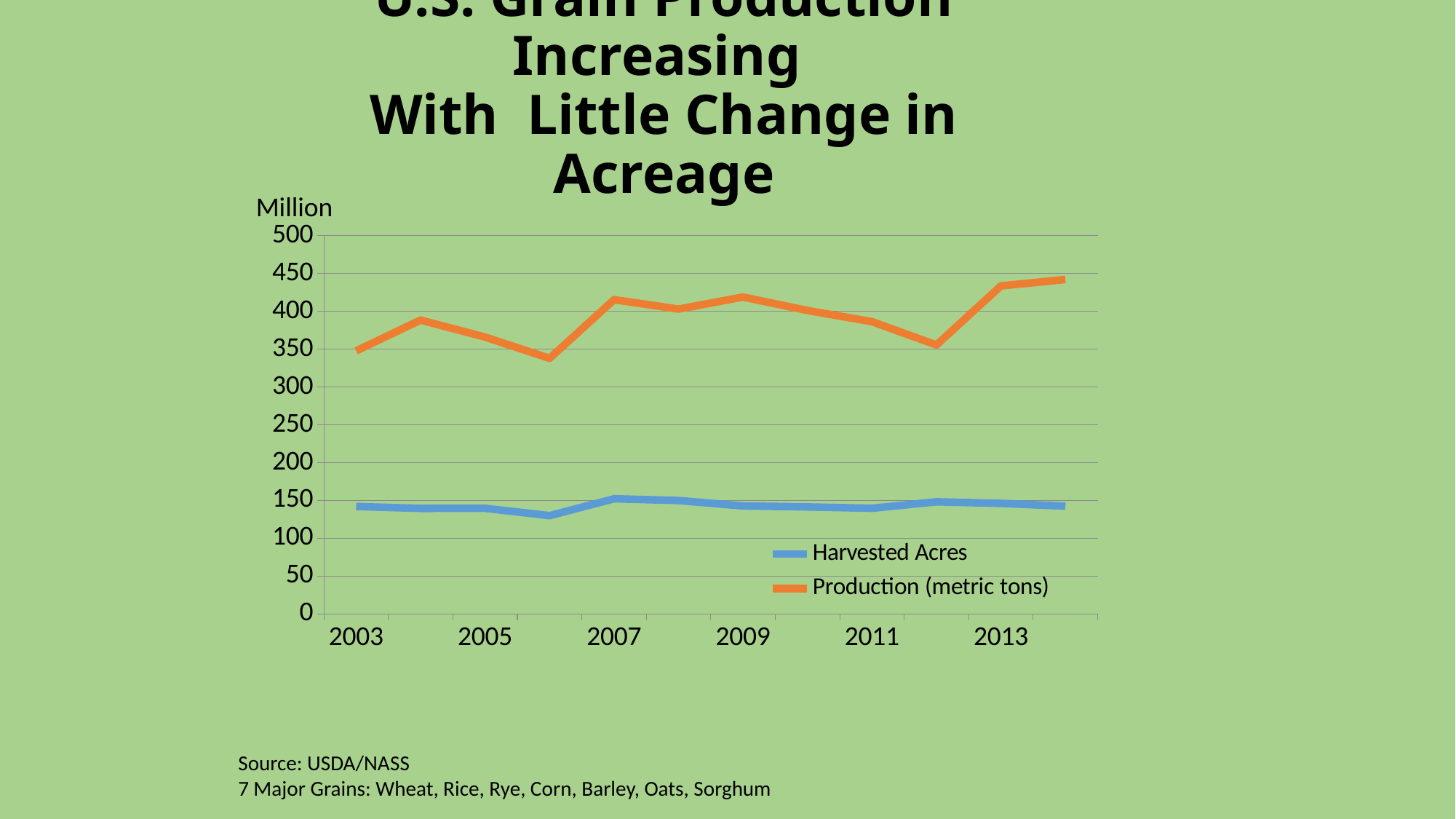
What unit label appears above the vertical axis? Million Which is larger, Production (metric tons) in 2013 or in 2012? 2013 Is the value for Harvested Acres in 2006 greater or less than 150? less Does Production (metric tons) rise or fall from 2012 to 2014? rise Is the value for Production (metric tons) in 2003 greater or less than 300? greater Is the value for Harvested Acres in 2003 greater or less than 100? greater How many series does the legend list? 2 Which is larger, Production (metric tons) in 2007 or in 2006? 2007 In which year is Production (metric tons) at its lowest? 2006 What are the two series named in the legend? Harvested Acres; Production (metric tons) What kind of chart is shown on the slide? line chart